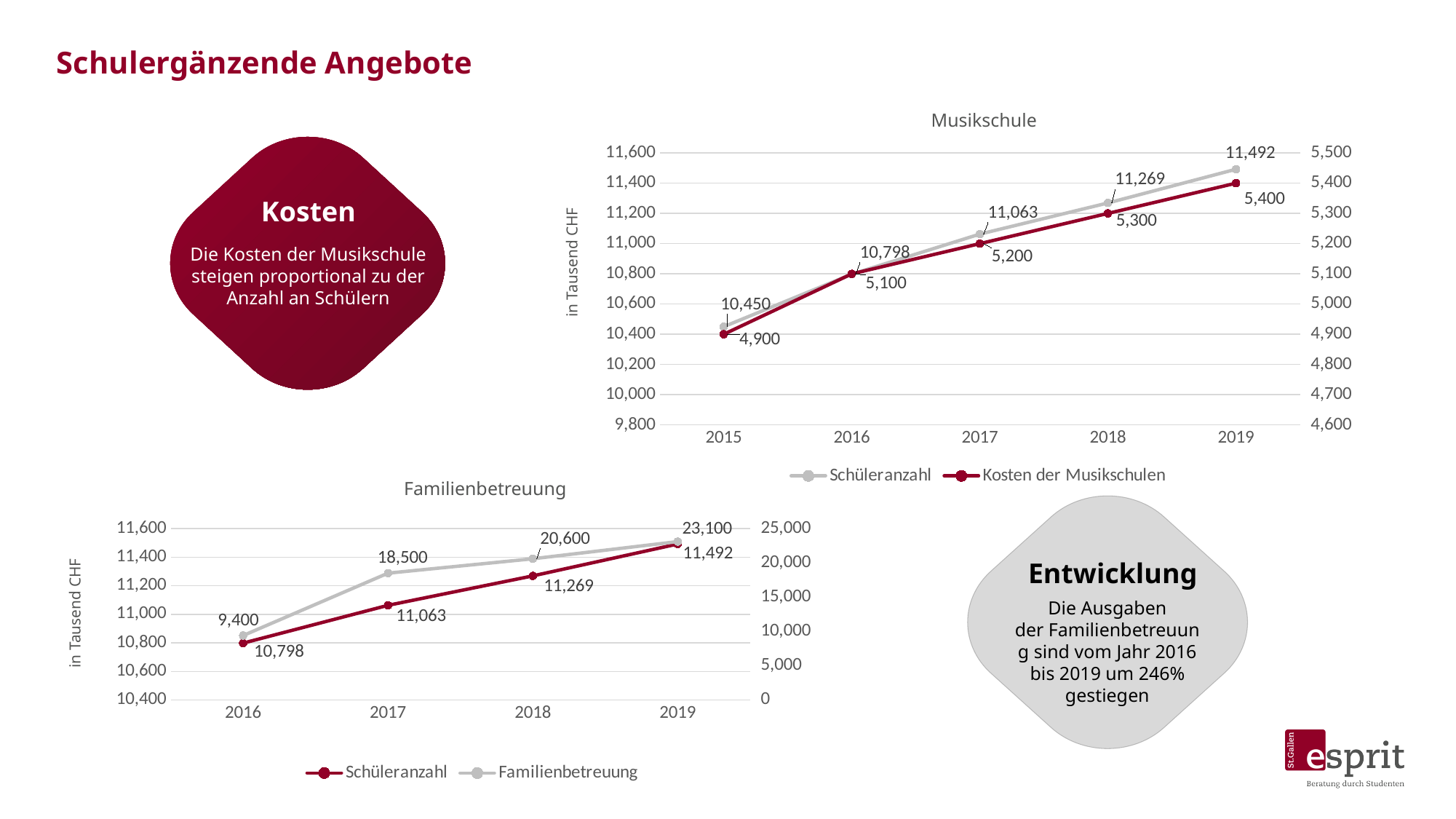
In the Musikschule chart, what is the Schüleranzahl value for 2017? 11,063 In the Musikschule chart, what is the value of Kosten der Musikschulen in 2019? 5,400 In the Familienbetreuung chart, which year has the highest Familienbetreuung value? 2019 In the Musikschule chart, what is the difference between the Schüleranzahl values for 2019 and 2015? 1,042 In the Musikschule chart, which year has the lowest Kosten der Musikschulen value? 2015 What type of chart is the Familienbetreuung chart? line chart In the Musikschule chart, how many years are shown on the x axis? 5 In the Familienbetreuung chart, what is the Schüleranzahl value for 2018? 11,269 In the Familienbetreuung chart, how many series does the legend list? 2 In the Familienbetreuung chart, what is the difference between the Familienbetreuung values for 2019 and 2016? 13,700 In the Familienbetreuung chart, what is the Familienbetreuung value for 2017? 18,500 In the Musikschule chart, does the Kosten der Musikschulen series rise or fall from 2015 to 2019? rise